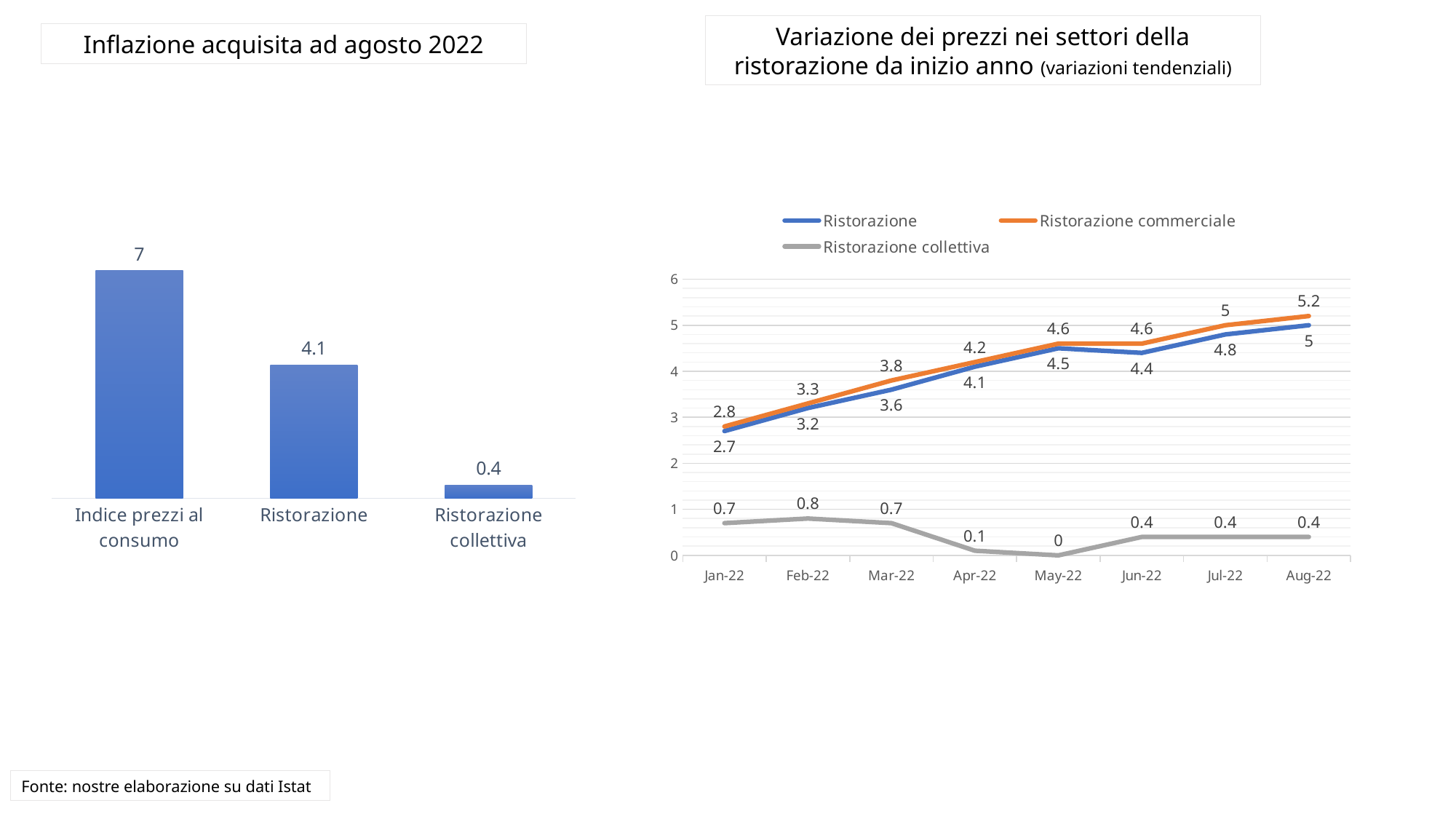
In the line chart on the right, how many months are plotted on the x axis? 8 In the line chart on the right, what is the value for Ristorazione commerciale in Aug-22? 5.2 What kind of chart is 'Inflazione acquisita ad agosto 2022'? bar chart In the line chart on the right, what is the value for Ristorazione collettiva in May-22? 0 In the line chart on the right, does the Ristorazione commerciale series rise or fall from Jan-22 to Aug-22? rise How many categories are shown in the chart 'Inflazione acquisita ad agosto 2022'? 3 In the chart 'Inflazione acquisita ad agosto 2022', what is the difference between Indice prezzi al consumo and Ristorazione? 2.9 In the chart 'Inflazione acquisita ad agosto 2022', which category has the lowest value? Ristorazione collettiva In the chart 'Inflazione acquisita ad agosto 2022', what is the value for Indice prezzi al consumo? 7 In the line chart on the right, what is the difference between Ristorazione commerciale and Ristorazione in Jul-22? 0.2 In the line chart on the right, how many series does the legend list? 3 In the line chart on the right, which is larger in Jun-22: Ristorazione or Ristorazione collettiva? Ristorazione